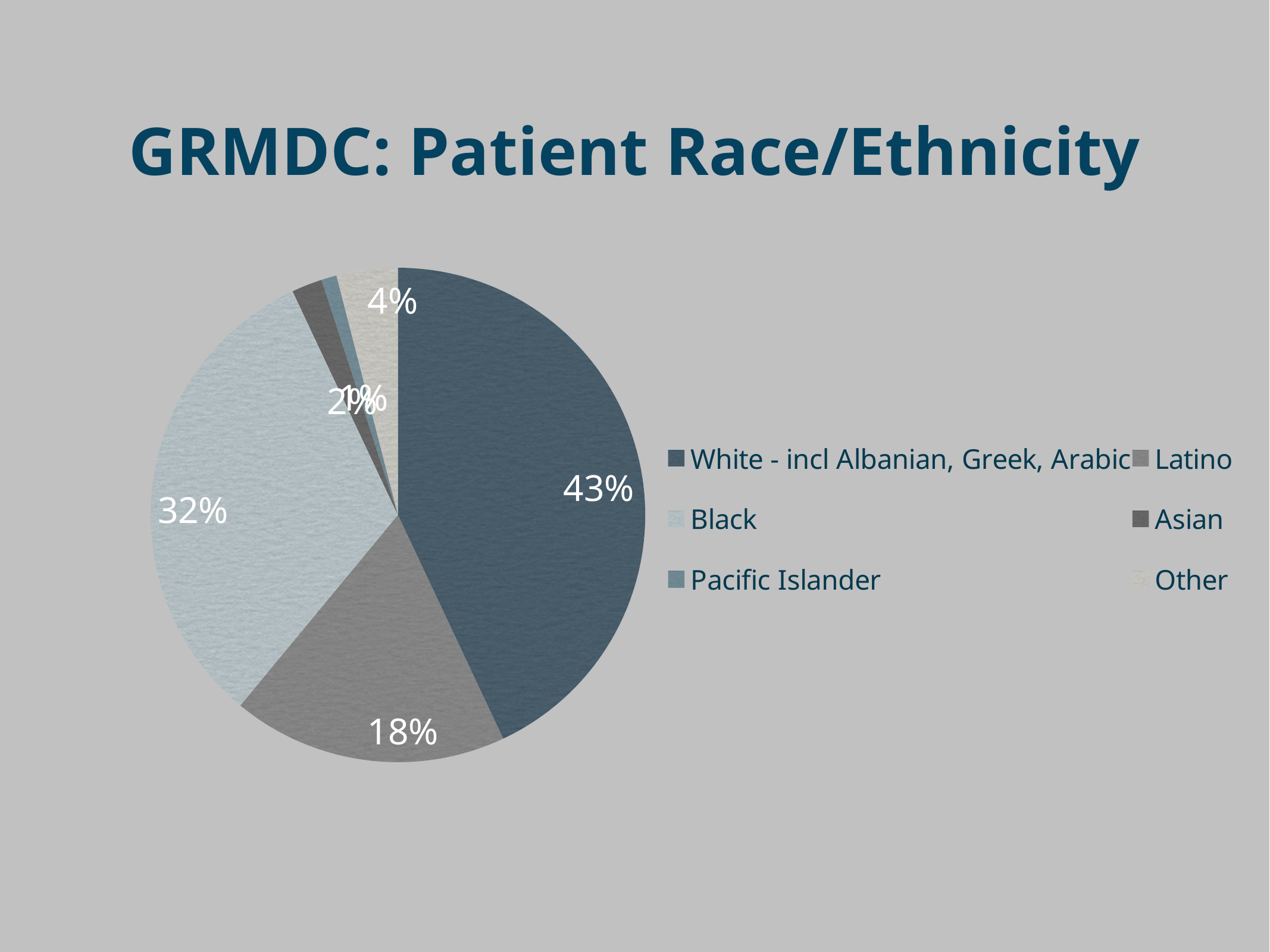
Which race/ethnicity category has the largest share of patients? White - incl Albanian, Greek, Arabic What percentage of patients fall into the Other category? 4% How many percentage points larger is the White share than the Black share? 11% What is the title of the slide? GRMDC: Patient Race/Ethnicity Which is larger, the Black share or the Latino share? Black What percentage of patients are White (incl Albanian, Greek, Arabic)? 43% What percentage of patients are Black? 32% What type of chart is shown on the slide? Pie chart How many race/ethnicity categories are shown in the pie chart? 6 What is the difference between the Black share and the Latino share? 14% Which race/ethnicity category has the smallest share of patients? Pacific Islander What percentage of patients are Latino? 18%